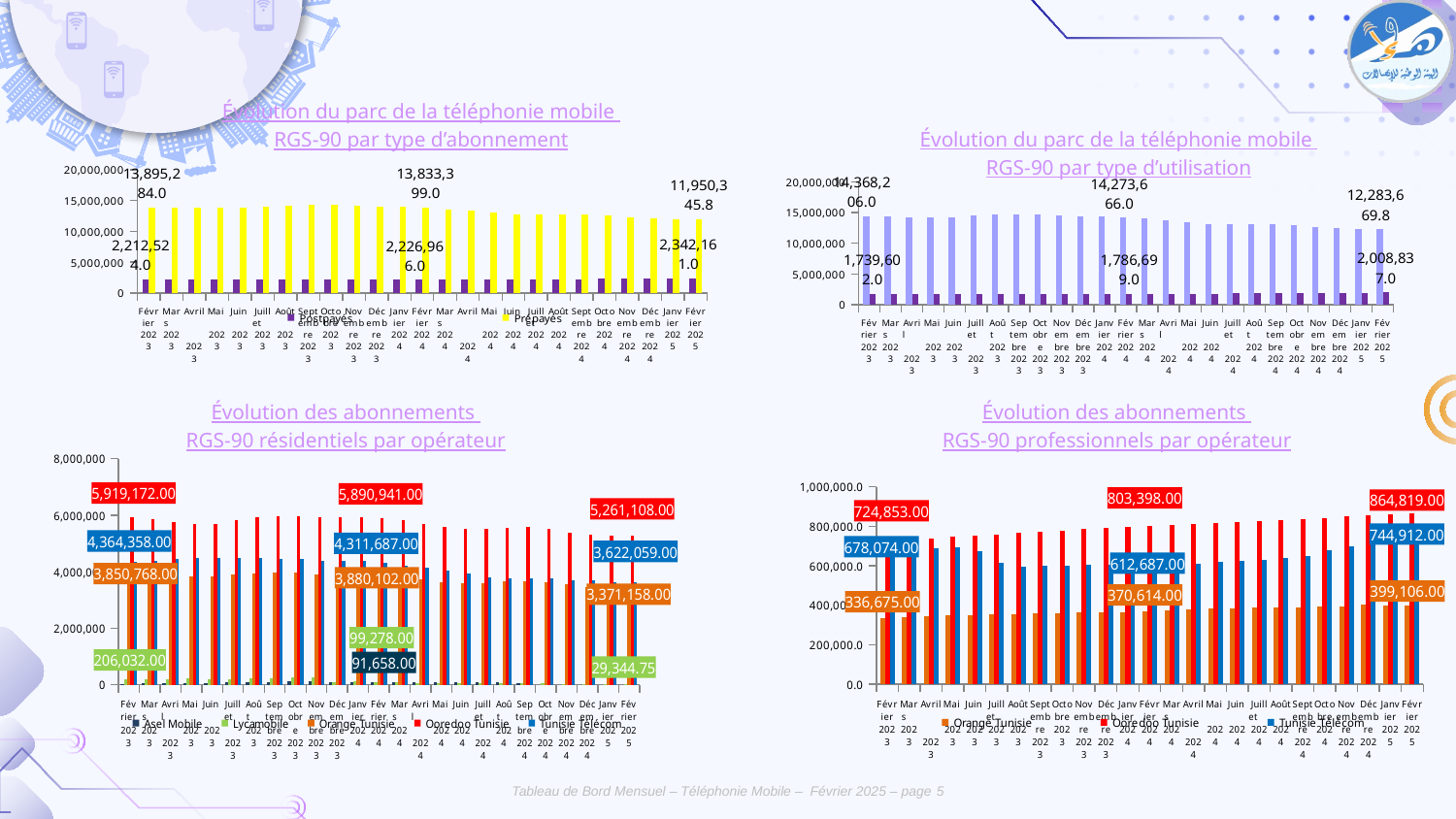
In the chart 'Évolution des abonnements RGS-90 résidentiels par opérateur', which is larger in Février 2025: Ooredoo Tunisie or Tunisie Telecom? Ooredoo Tunisie How many series does the legend list in the chart 'Évolution des abonnements RGS-90 professionnels par opérateur'? 3 In the chart 'Évolution des abonnements RGS-90 résidentiels par opérateur', what is the value for Ooredoo Tunisie in Février 2023? 5,919,172.00 In the chart 'Évolution des abonnements RGS-90 professionnels par opérateur', what is the value for Ooredoo Tunisie in Février 2025? 864,819.00 In the chart 'Évolution du parc de la téléphonie mobile RGS-90 par type d'abonnement', do the Prépayés values rise or fall from Février 2023 to Février 2025? Fall What type of chart is 'Évolution des abonnements RGS-90 professionnels par opérateur'? Bar chart In the chart 'Évolution du parc de la téléphonie mobile RGS-90 par type d'abonnement', is the Postpayés value for Février 2025 greater or less than 5,000,000? less How many charts are shown on the slide? 4 In the chart 'Évolution des abonnements RGS-90 professionnels par opérateur', what is the value for Orange Tunisie in Février 2023? 336,675.00 In the chart 'Évolution des abonnements RGS-90 résidentiels par opérateur', what is the value for Tunisie Telecom in Février 2025? 3,622,059.00 In the chart 'Évolution des abonnements RGS-90 professionnels par opérateur', what is the value for Tunisie Telecom in Février 2024? 612,687.00 In the chart 'Évolution des abonnements RGS-90 professionnels par opérateur', what is the difference between the Ooredoo Tunisie values for Février 2025 and Février 2023? 139,966.00